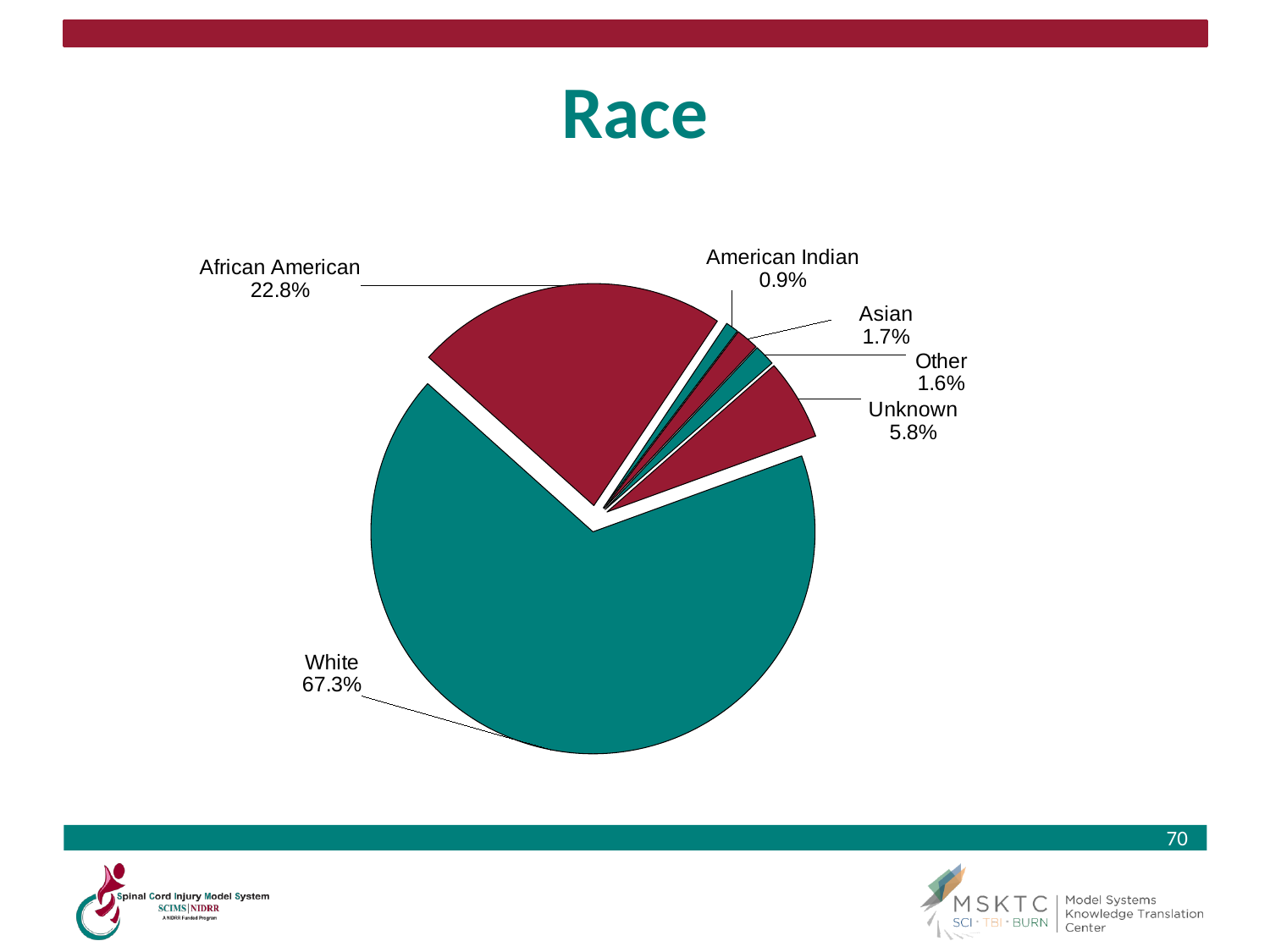
How many slices does the pie chart have? 6 Which category has the smallest share of the pie? American Indian What percentage of the pie is Asian? 1.7% What percentage of the pie is White? 67.3% Which is larger, the Unknown share or the Other share? Unknown What kind of chart is shown on the slide? pie chart What is the difference between the White and African American shares? 44.5% What percentage of the pie is Unknown? 5.8% What percentage of the pie is African American? 22.8% What percentage of the pie is American Indian? 0.9% Which category has the largest share of the pie? White What is the title of the chart? Race